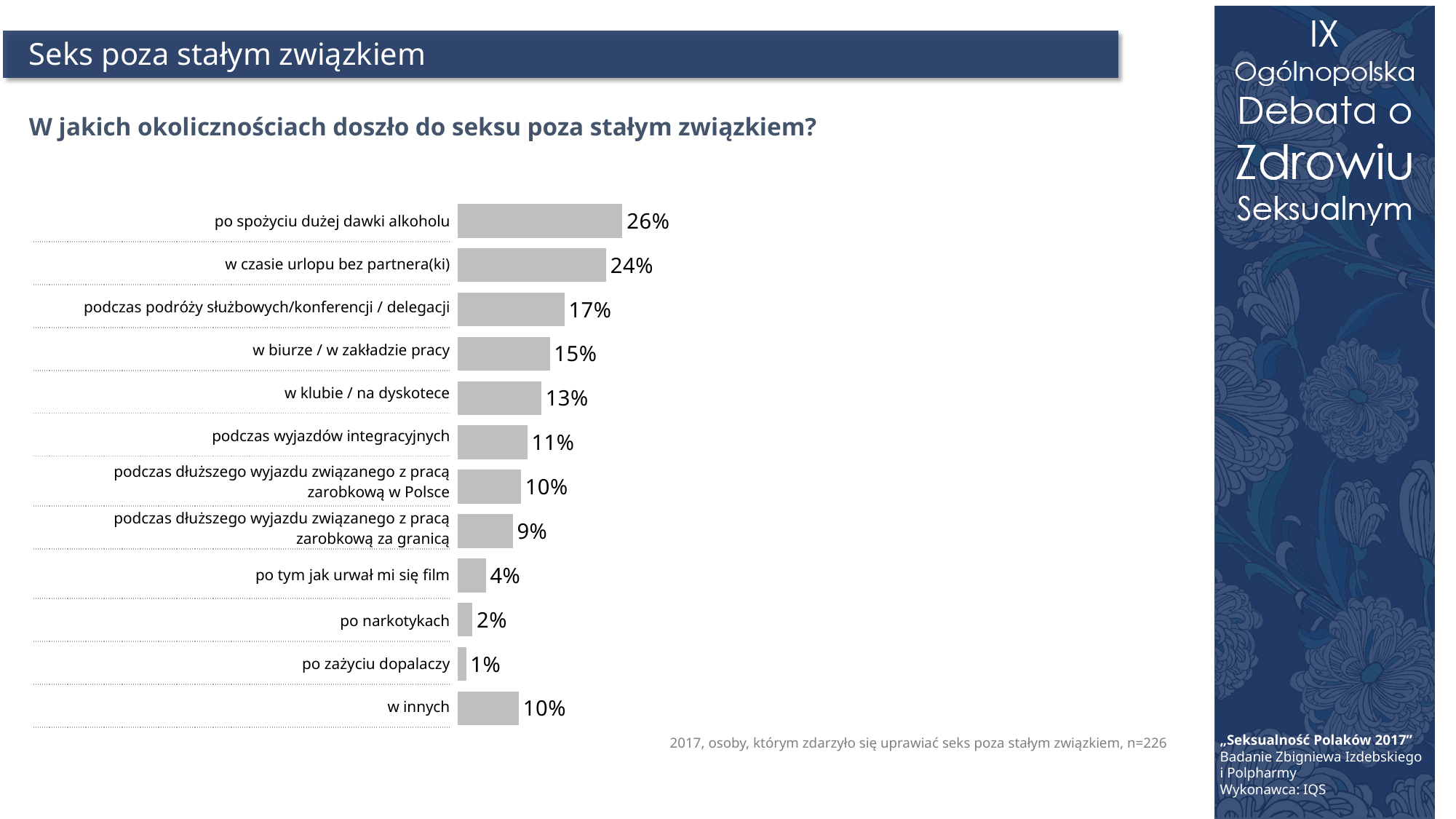
How many categories are shown in the chart? 12 What is the value for "w innych"? 10% What is the value for "w biurze / w zakładzie pracy"? 15% Which category has the lowest value? po zażyciu dopalaczy What kind of chart is shown on the slide? bar chart What is the difference between "po tym jak urwał mi się film" and "po zażyciu dopalaczy"? 3% What is the value for "po spożyciu dużej dawki alkoholu"? 26% Which category has the highest value? po spożyciu dużej dawki alkoholu What is the sample size (n) stated below the chart? n=226 What is the difference between "w czasie urlopu bez partnera(ki)" and "podczas podróży służbowych/konferencji / delegacji"? 7% Which is larger: "w klubie / na dyskotece" or "podczas wyjazdów integracyjnych"? w klubie / na dyskotece What is the value for "po narkotykach"? 2%